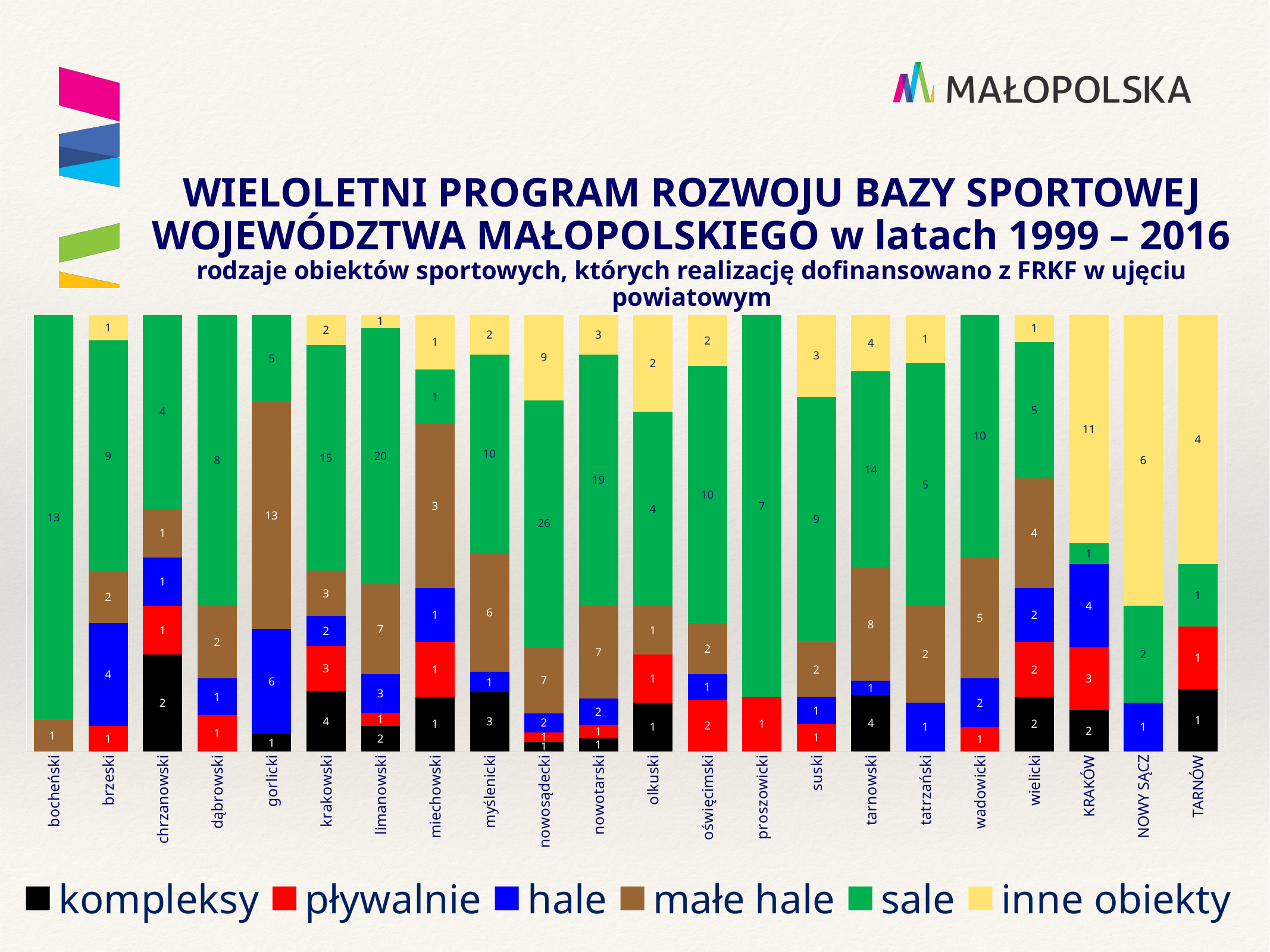
What type of chart is shown on the slide? stacked bar chart What is the difference between the 'sale' values for limanowski and nowotarski? 1 How many powiat categories are shown along the x axis? 22 What is the value of 'sale' for nowosądecki? 26 What is the total of all segments in the NOWY SĄCZ bar? 9 How many series does the legend list? 6 What is the total of all segments in the bocheński bar? 14 Which category has the highest value for 'sale'? nowosądecki What is the value of 'małe hale' for gorlicki? 13 What is the value of 'inne obiekty' for KRAKÓW? 11 Which category has the highest value for 'inne obiekty'? KRAKÓW Which is larger, the 'hale' value for gorlicki or the 'hale' value for brzeski? gorlicki